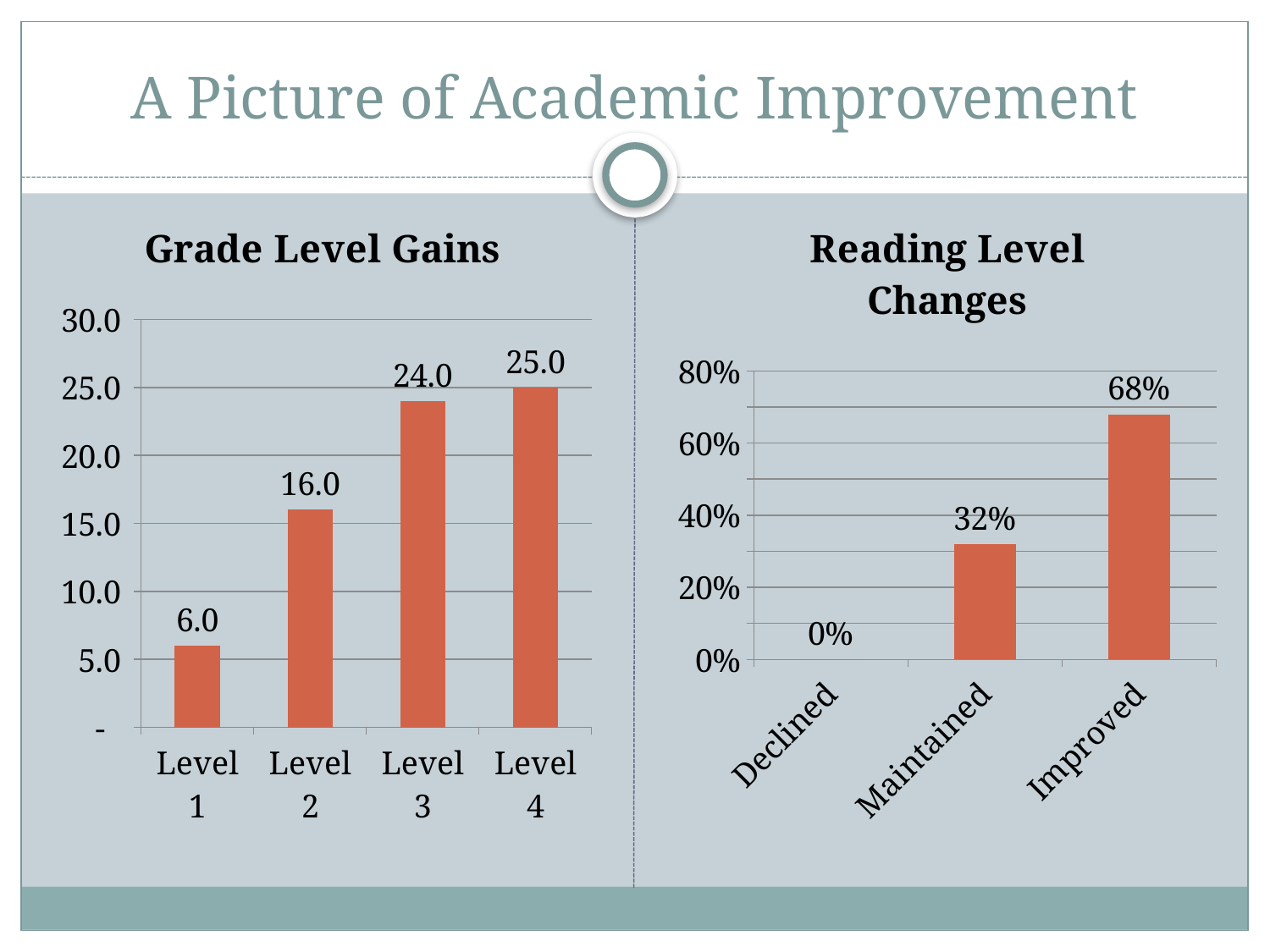
In the Reading Level Changes chart, which category has the highest value? Improved In the Reading Level Changes chart, what is the difference between the values for Improved and Maintained? 36% What kind of chart is the Grade Level Gains chart? bar chart In the Grade Level Gains chart, what is the value for Level 2? 16.0 In the Grade Level Gains chart, which level has the lowest value? Level 1 In the Grade Level Gains chart, how many levels are shown on the x axis? 4 In the Grade Level Gains chart, which level has the highest value? Level 4 In the Reading Level Changes chart, what is the value for Declined? 0% In the Grade Level Gains chart, do the values rise or fall from Level 1 to Level 4? rise In the Grade Level Gains chart, what is the difference between the values for Level 3 and Level 1? 18.0 In the Reading Level Changes chart, what is the value for Maintained? 32% In the Reading Level Changes chart, how many categories are shown on the x axis? 3